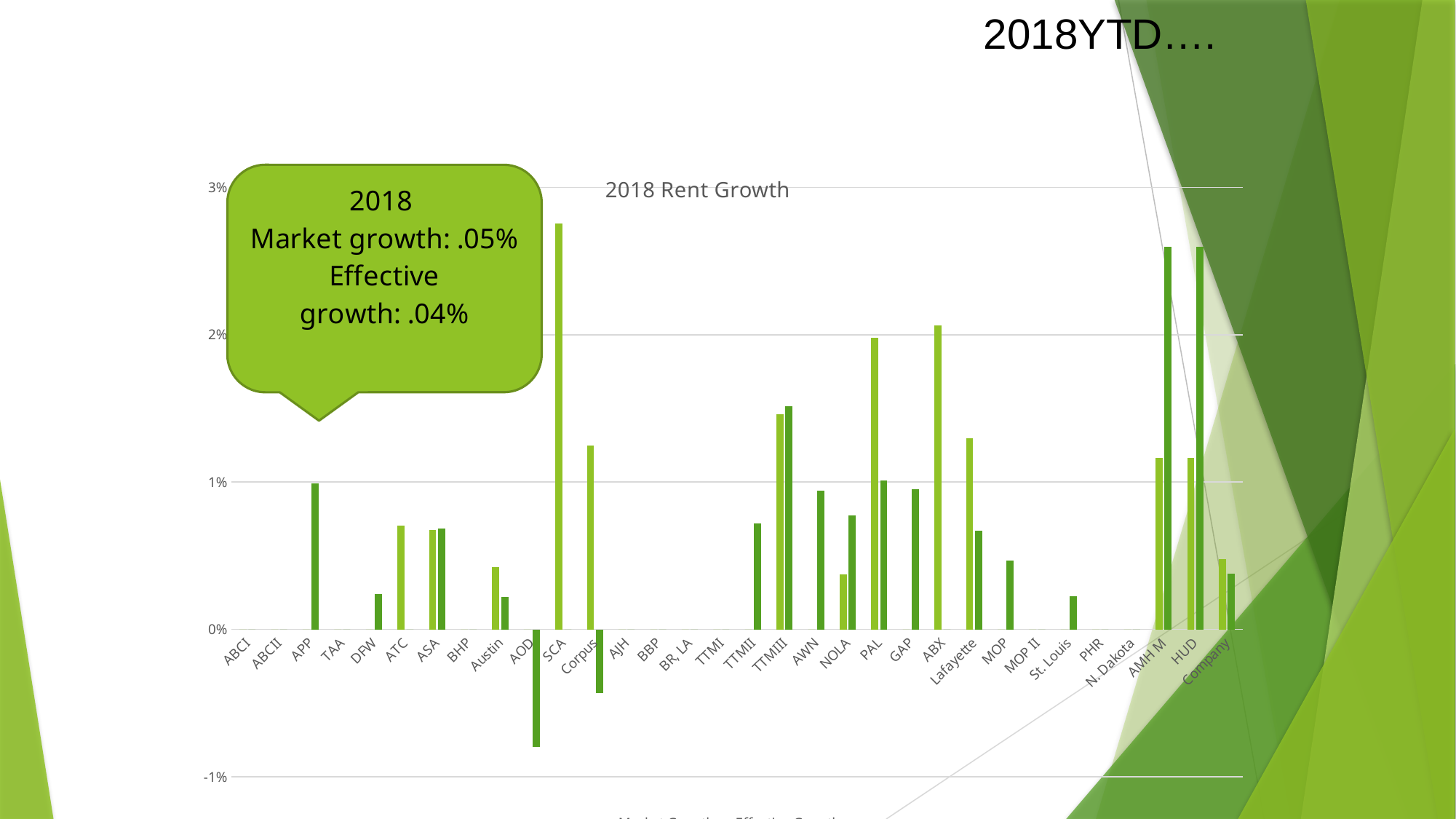
What is the title of the chart? 2018 Rent Growth Which has the taller light green bar, SCA or Corpus? SCA According to the callout on the slide, what was the 2018 market growth? .05% Which category has the tallest bar in the chart? SCA Is the light green bar for SCA greater or less than 2%? greater Is the dark green bar for TTMII greater or less than 1%? less What type of chart is shown on the slide? bar chart How many categories are listed along the x axis of the chart? 32 Is the light green bar for Corpus greater or less than 1%? greater Which category has the lowest (most negative) bar in the chart? AOD